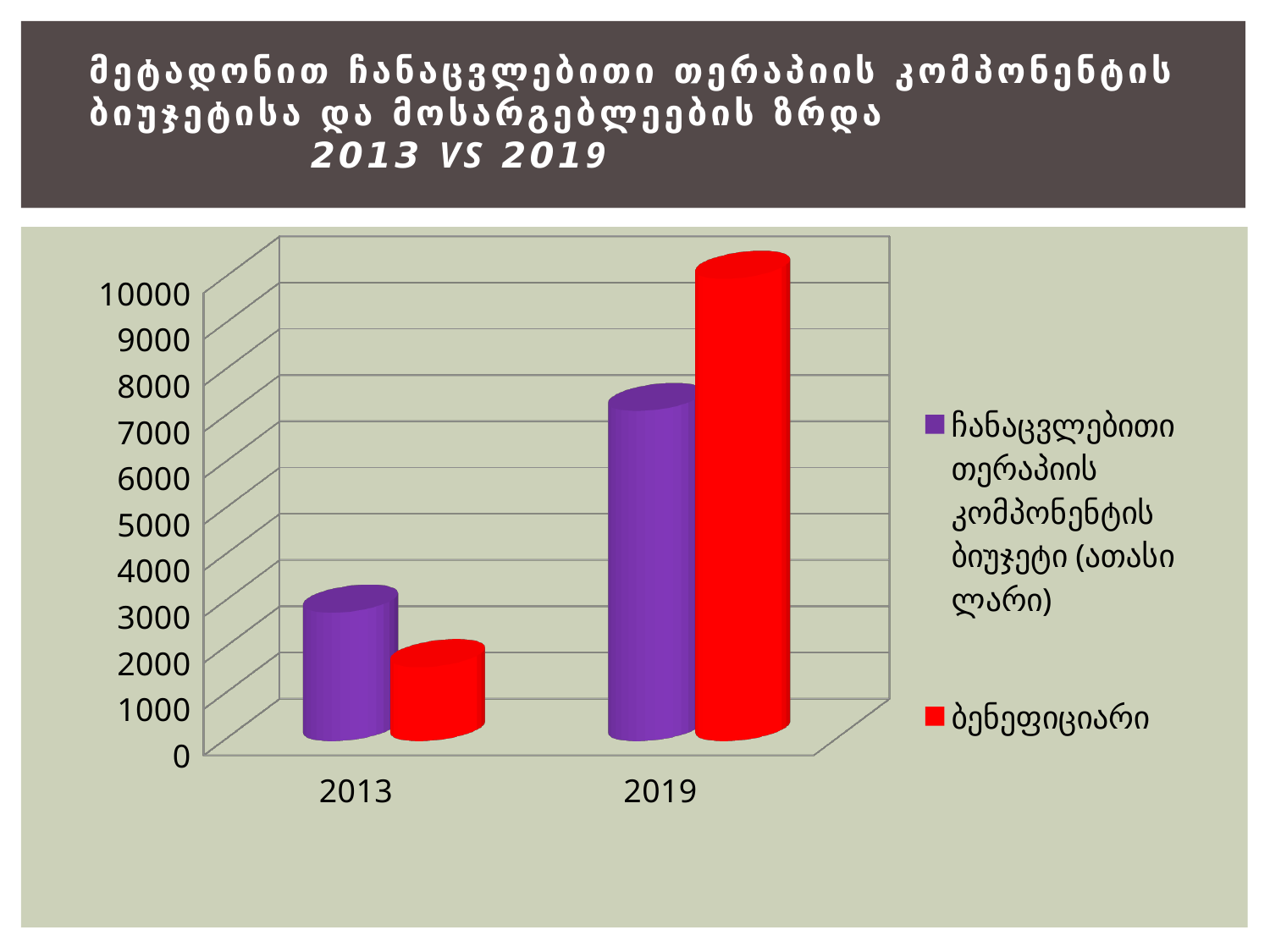
How many series does the legend list? 2 Do the values for ბენეფიციარი rise or fall from 2013 to 2019? rise In 2013, which series has the larger value: ჩანაცვლებითი თერაპიის კომპონენტის ბიუჯეტი or ბენეფიციარი? ჩანაცვლებითი თერაპიის კომპონენტის ბიუჯეტი What colour represents the ბენეფიციარი series in the legend? red Is the value for ბენეფიციარი in 2013 greater or less than 3000? less What kind of chart is shown on the slide? bar chart In 2019, which series has the larger value: ჩანაცვლებითი თერაპიის კომპონენტის ბიუჯეტი or ბენეფიციარი? ბენეფიციარი How many categories are shown on the x axis? 2 Which bar is the lowest in the chart? ბენეფიციარი in 2013 Is the value for ბენეფიციარი in 2019 greater or less than 9000? greater Which year has the tallest bar in the chart? 2019 Which series has the highest value in the chart? ბენეფიციარი